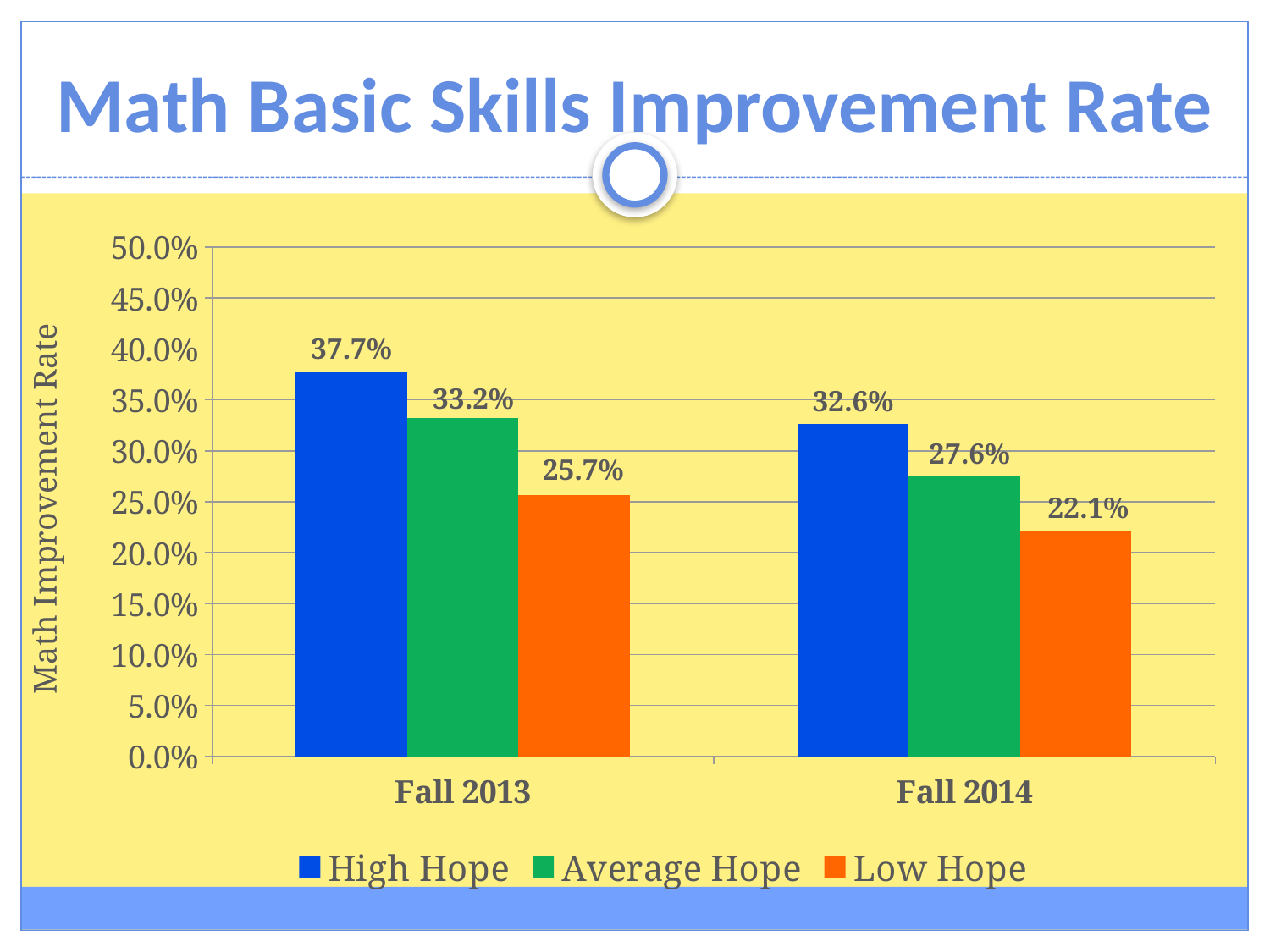
How many series does the legend list? 3 How many categories are shown on the x axis? 2 Which group has the highest Math Improvement Rate in Fall 2013? High Hope What is the difference between the High Hope rate in Fall 2013 and the High Hope rate in Fall 2014? 5.1% Does the Low Hope rate rise or fall from Fall 2013 to Fall 2014? Fall What is the Math Improvement Rate for High Hope in Fall 2013? 37.7% Which group has the lowest Math Improvement Rate in Fall 2014? Low Hope What kind of chart is shown on the slide? Bar chart What is the Math Improvement Rate for Average Hope in Fall 2014? 27.6% Which is larger: the Average Hope rate in Fall 2013 or the High Hope rate in Fall 2014? Average Hope in Fall 2013 What is the difference between the High Hope and Low Hope rates in Fall 2013? 12.0% What is the Math Improvement Rate for Low Hope in Fall 2014? 22.1%